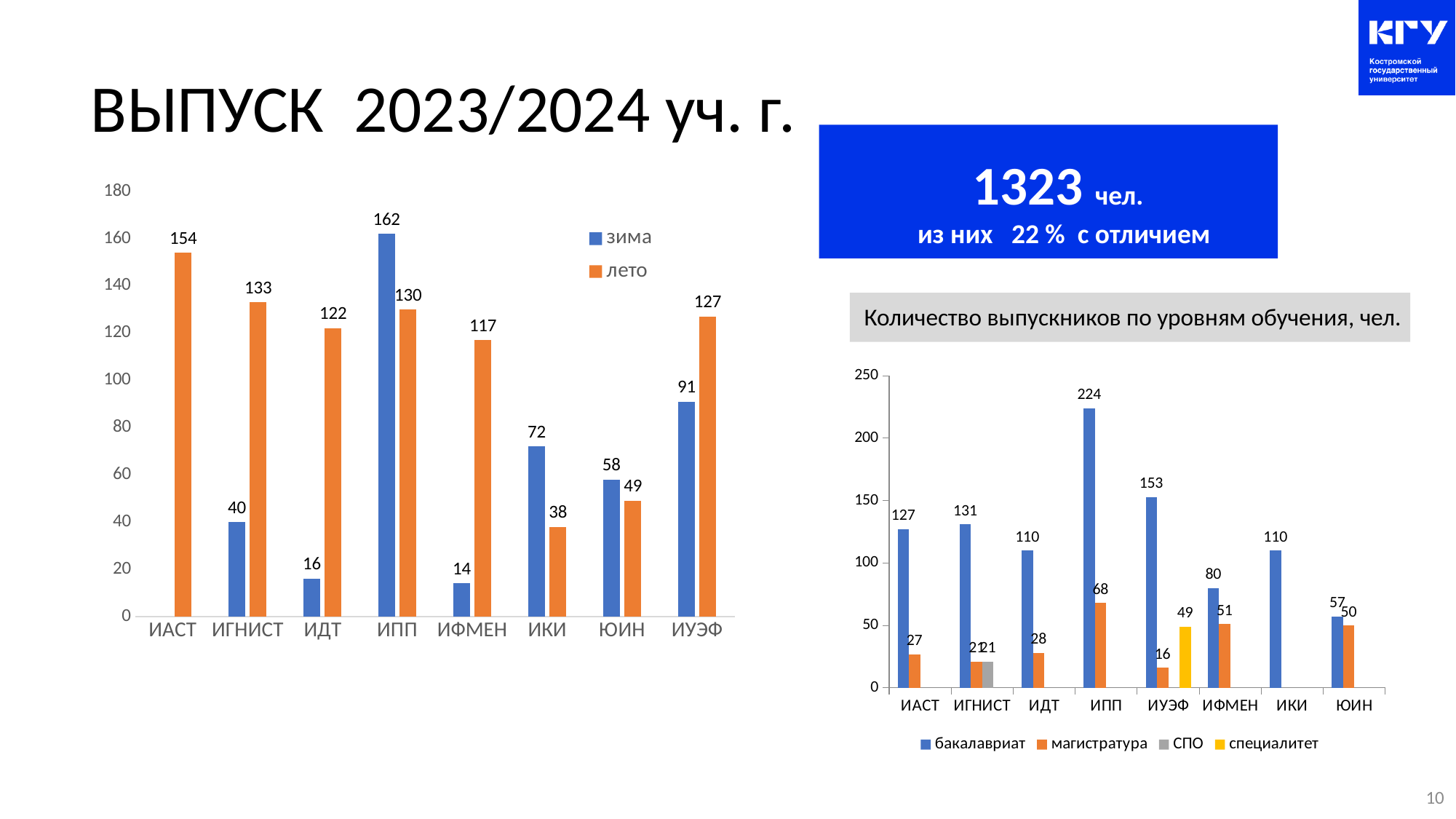
In the left chart, what is the value for лето for ИАСТ? 154 In the left chart, what is the value for зима for ИПП? 162 In the left chart, which category has the lowest лето value? ИКИ In the left chart, which category has the highest зима value? ИПП In the chart titled 'Количество выпускников по уровням обучения, чел.', what is the специалитет value for ИУЭФ? 49 In the chart titled 'Количество выпускников по уровням обучения, чел.', how many series does the legend list? 4 In the left chart, which is larger for ЮИН: зима or лето? зима In the chart titled 'Количество выпускников по уровням обучения, чел.', which category has the highest бакалавриат value? ИПП In the left chart, what is the difference between the лето and зима values for ИГНИСТ? 93 In the left chart, how many series does the legend list? 2 What type of chart is the chart titled 'Количество выпускников по уровням обучения, чел.'? bar chart In the chart titled 'Количество выпускников по уровням обучения, чел.', what is the бакалавриат value for ИПП? 224